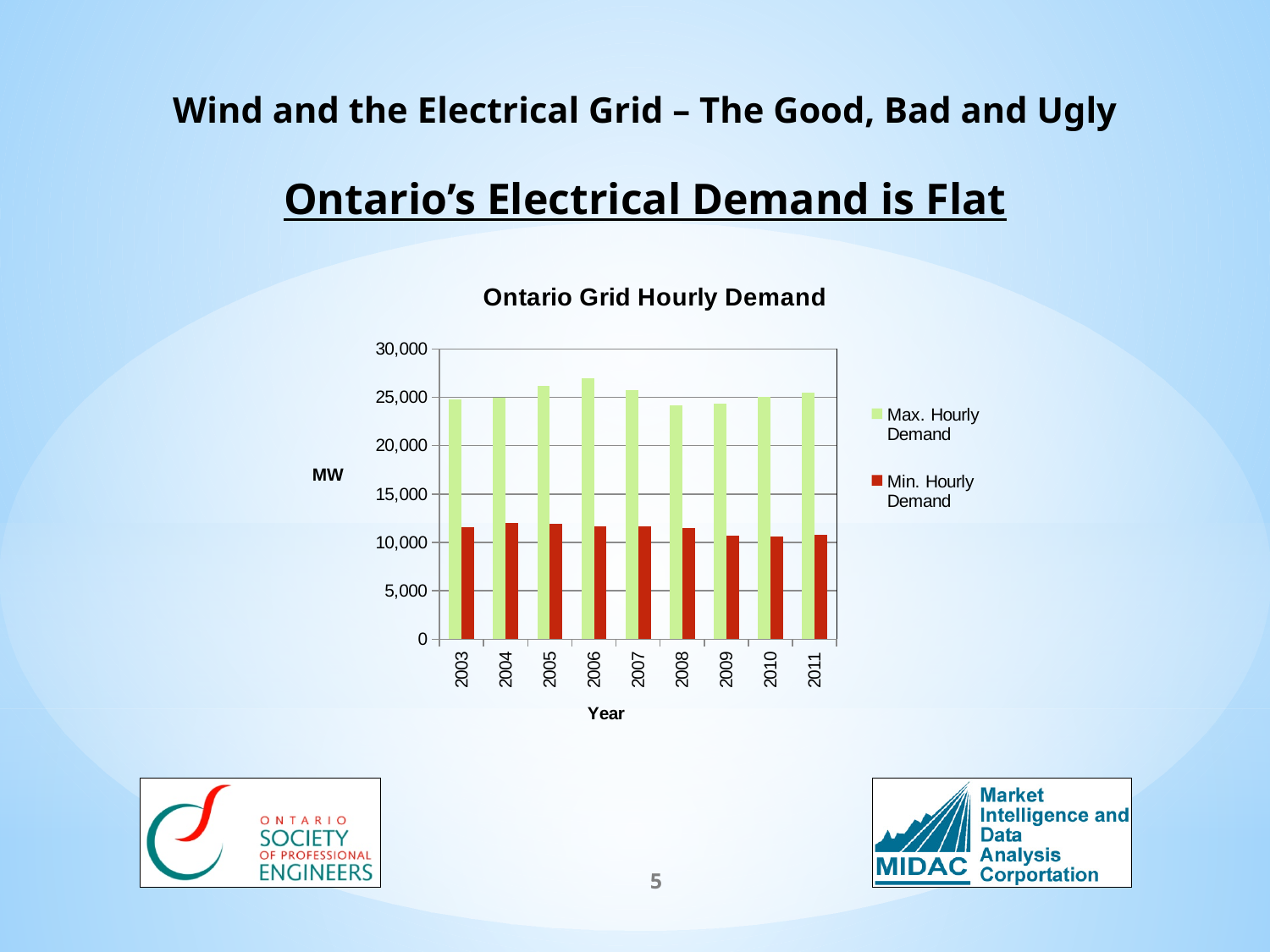
Is the Max. Hourly Demand for 2006 greater or less than 25,000? greater Is the Min. Hourly Demand for 2009 greater or less than 10,000? greater Is the Min. Hourly Demand for 2004 greater or less than 15,000? less Which year has the highest Max. Hourly Demand? 2006 What is the title of the chart? Ontario Grid Hourly Demand Which is larger, the Min. Hourly Demand for 2004 or for 2010? 2004 What unit is shown on the vertical axis label of the chart? MW Which is larger, the Max. Hourly Demand for 2006 or for 2008? 2006 What type of chart is shown on the slide? bar chart How many years are shown on the x axis of the chart? 9 How many series does the chart legend list? 2